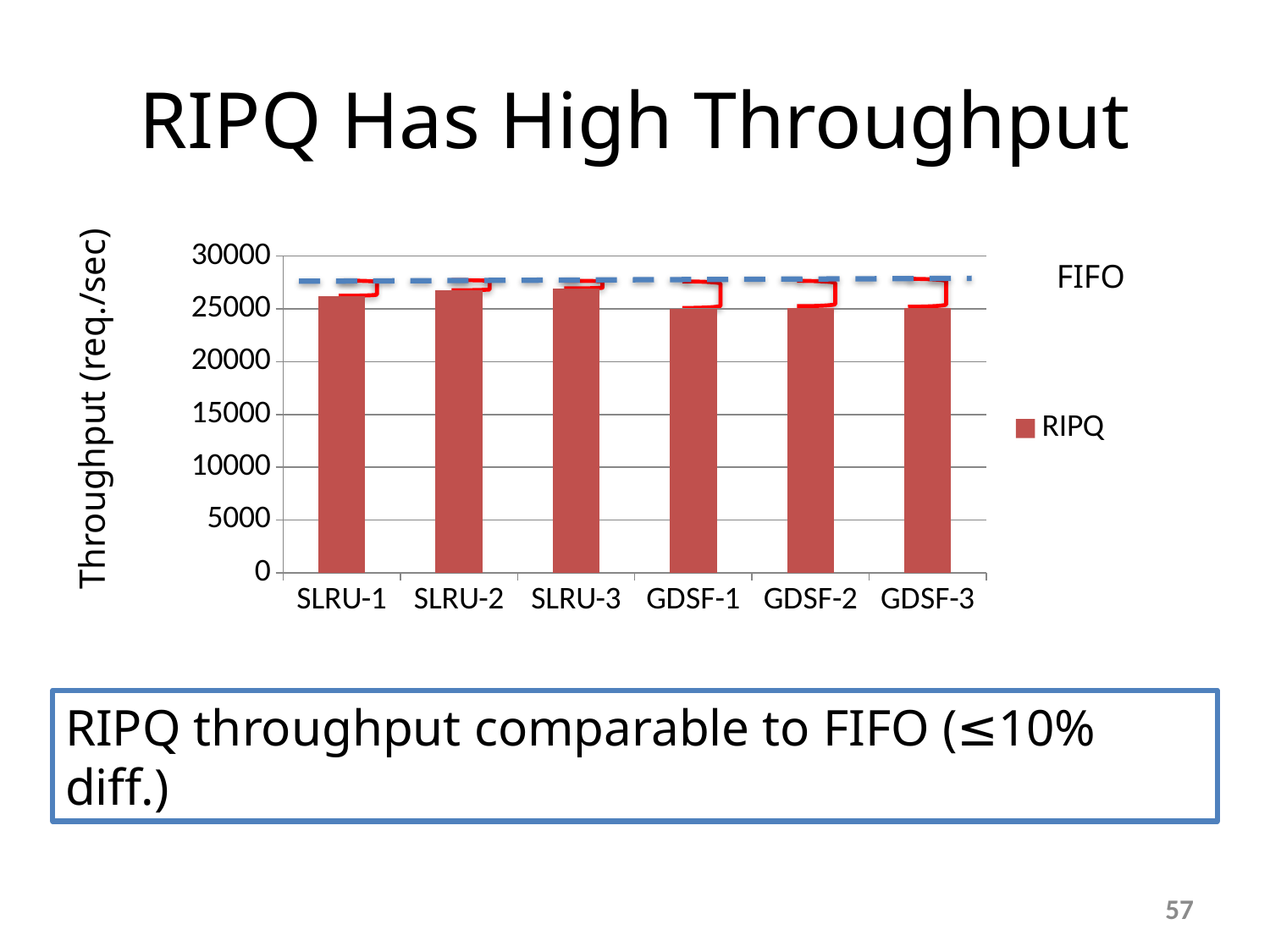
Is the RIPQ value for SLRU-2 greater or less than 25000? greater What is the label of the y axis of the chart? Throughput (req./sec) Is the RIPQ value for SLRU-1 greater or less than 25000? greater What kind of chart is shown on the slide? bar chart What is the title of the chart on the slide? RIPQ Has High Throughput Which has the larger RIPQ throughput, SLRU-3 or GDSF-3? SLRU-3 Is the RIPQ value for GDSF-2 greater or less than 20000? greater How many categories are shown on the x axis of the chart? 6 How many series does the chart's legend list? 1 Which has the larger RIPQ throughput, SLRU-1 or GDSF-1? SLRU-1